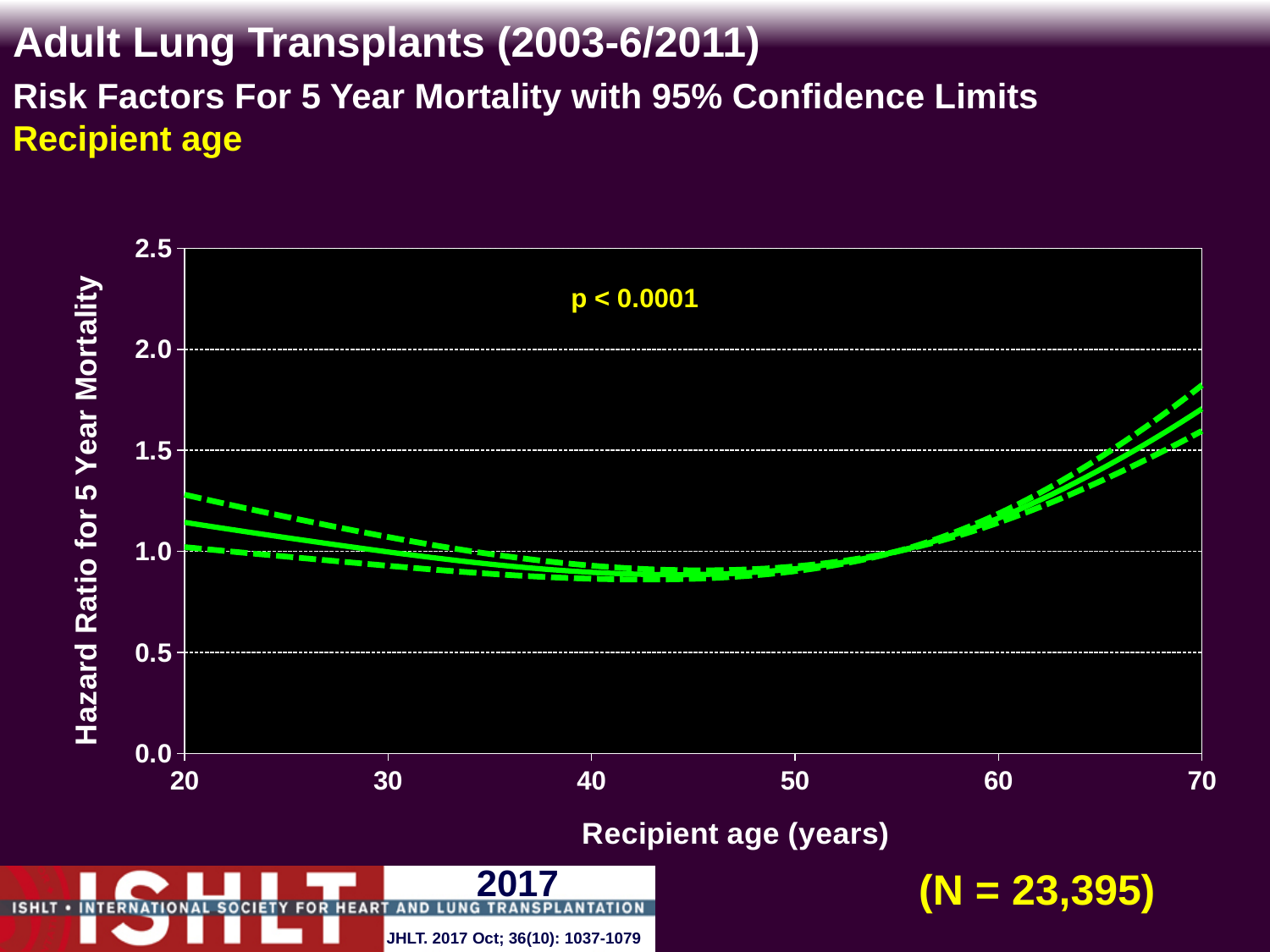
Does the hazard ratio rise or fall as recipient age increases from 20 to 40 years? fall What is the sample size (N) shown on the slide? N = 23,395 What kind of chart is shown on the slide? line chart Is the hazard ratio for 5 year mortality at recipient age 70 greater or less than 1.5? greater Is the hazard ratio for 5 year mortality at recipient age 20 greater or less than 1.0? greater Does the hazard ratio rise or fall as recipient age increases from 50 to 70 years? rise What is the p-value printed on the chart? p < 0.0001 Is the hazard ratio for 5 year mortality at recipient age 45 greater or less than 1.0? less How many lines (central estimate plus confidence limits) are plotted on the chart? 3 Which recipient age shown on the x axis has the lower hazard ratio, 30 or 60? 30 Which recipient age shown on the x axis has the higher hazard ratio, 20 or 70? 70